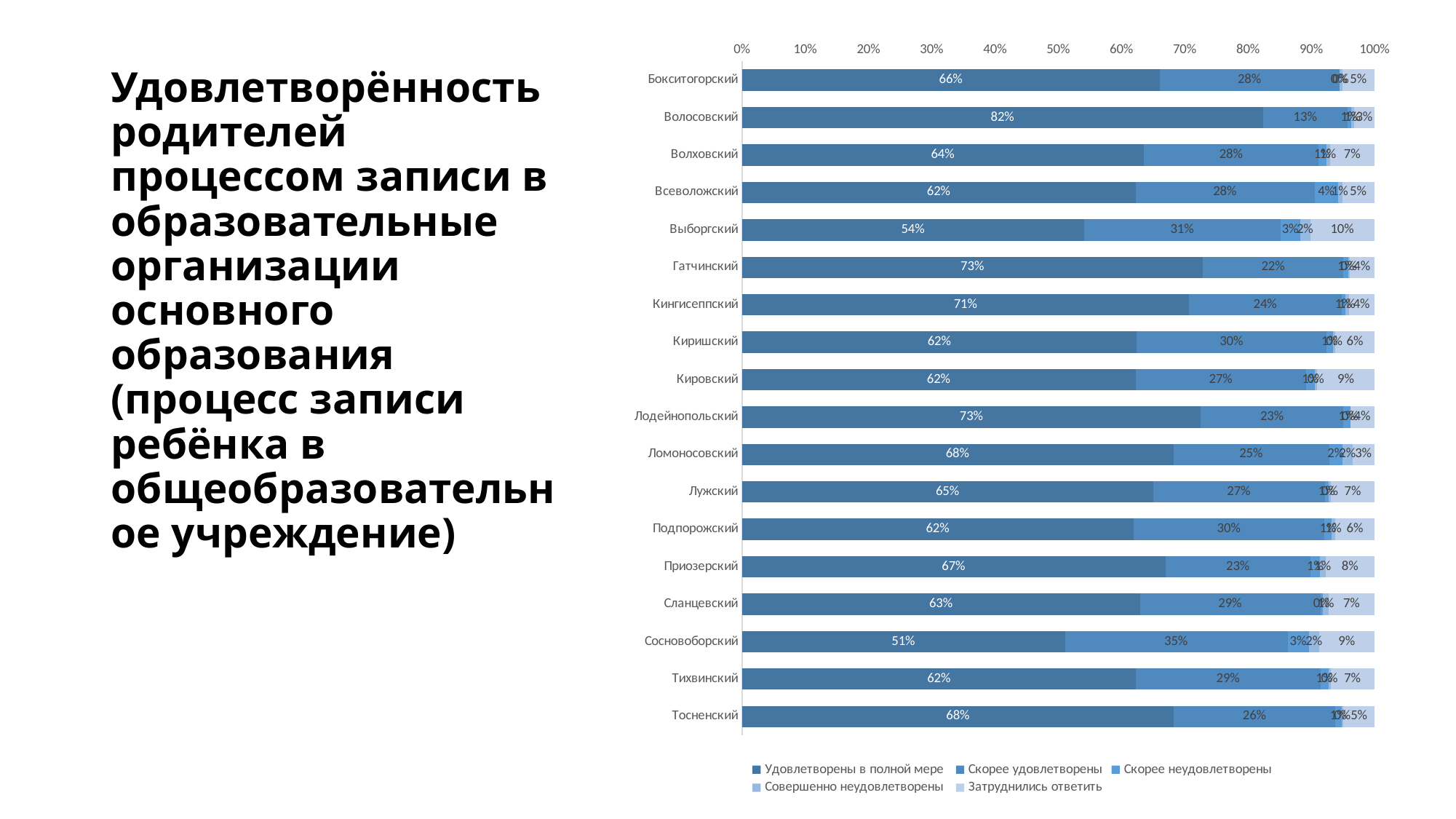
What kind of chart is shown on the slide? Stacked bar chart Which district has a larger "Удовлетворены в полной мере" share, Гатчинский or Кингисеппский? Гатчинский Is the "Удовлетворены в полной мере" value for Бокситогорский greater or less than 60%? greater What is the difference in percentage points between the "Удовлетворены в полной мере" values for Волосовский and Сосновоборский? 31 percentage points Which district has the highest "Скорее удовлетворены" share? Сосновоборский What is the "Затруднились ответить" value for Выборгский? 10% How many districts are shown on the chart? 18 Which district has the lowest share of "Удовлетворены в полной мере"? Сосновоборский Which district has the highest share of "Удовлетворены в полной мере"? Волосовский How many series does the legend list? 5 What percentage of parents in Волосовский are "Удовлетворены в полной мере"? 82% What is the "Скорее удовлетворены" value for Сосновоборский? 35%